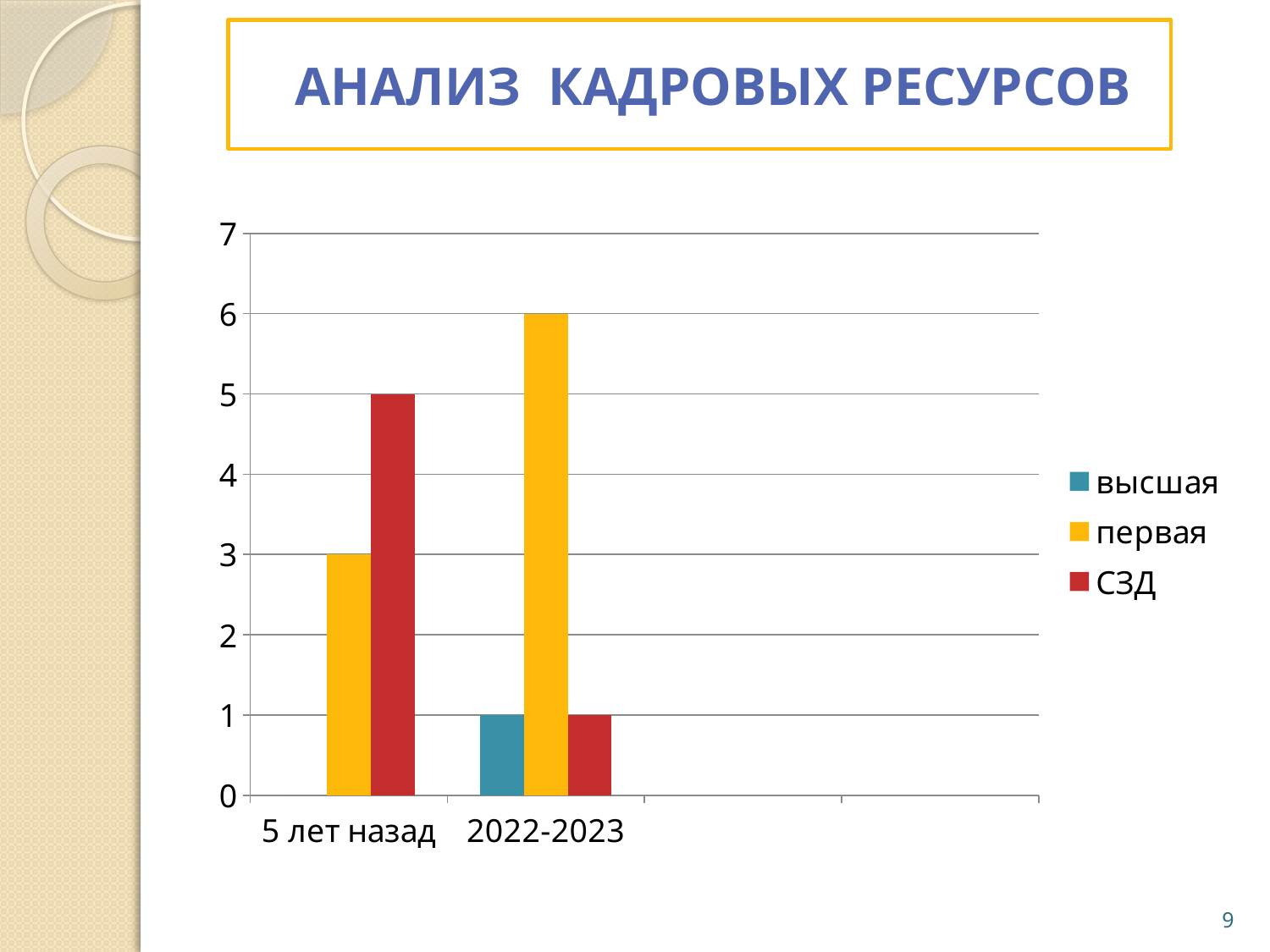
What is the value for первая in the category 2022-2023? 6 What is the title of the slide containing the chart? АНАЛИЗ КАДРОВЫХ РЕСУРСОВ What is the value for первая in the category 5 лет назад? 3 What is the value for высшая in the category 2022-2023? 1 Which is larger: the value for СЗД in 5 лет назад or in 2022-2023? 5 лет назад Which series has the highest value in the category 2022-2023? первая Which series has the highest value in the category 5 лет назад? СЗД How many series does the legend list? 3 What kind of chart is shown on the slide? bar chart How many categories are shown on the x axis? 2 What is the difference between the value for первая in 2022-2023 and in 5 лет назад? 3 What is the value for СЗД in the category 5 лет назад? 5